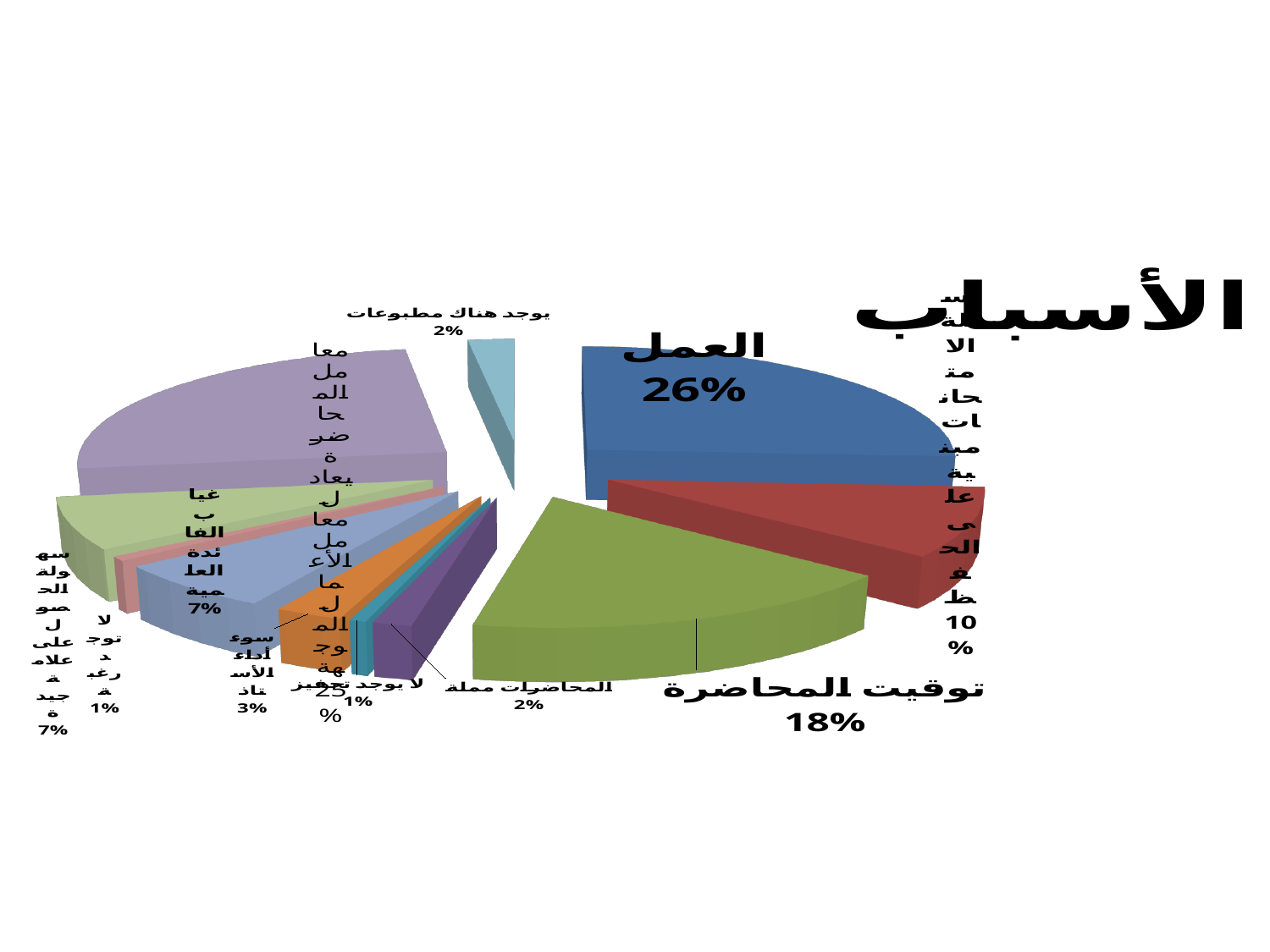
By how many percentage points does the share for العمل exceed the share for توقيت المحاضرة? 8 What percentage is shown for the slice labelled غياب الفائدة العلمية? 7% What percentage is shown for the slice labelled توقيت المحاضرة? 18% Which slice has the largest share of the pie? العمل What kind of chart is shown on the slide? Pie chart What percentage is shown for the slice labelled لا يوجد تحفيز? 1% What is the title of the chart? الأسباب What percentage is shown for the slice labelled يوجد هناك مطبوعات? 2% What percentage is shown for the slice labelled المحاضرات مملة? 2% What percentage is shown for the slice labelled العمل? 26% What percentage is shown for the slice labelled سوء أداء الأستاذ? 3% Which is larger, the share for العمل or the share for توقيت المحاضرة? العمل